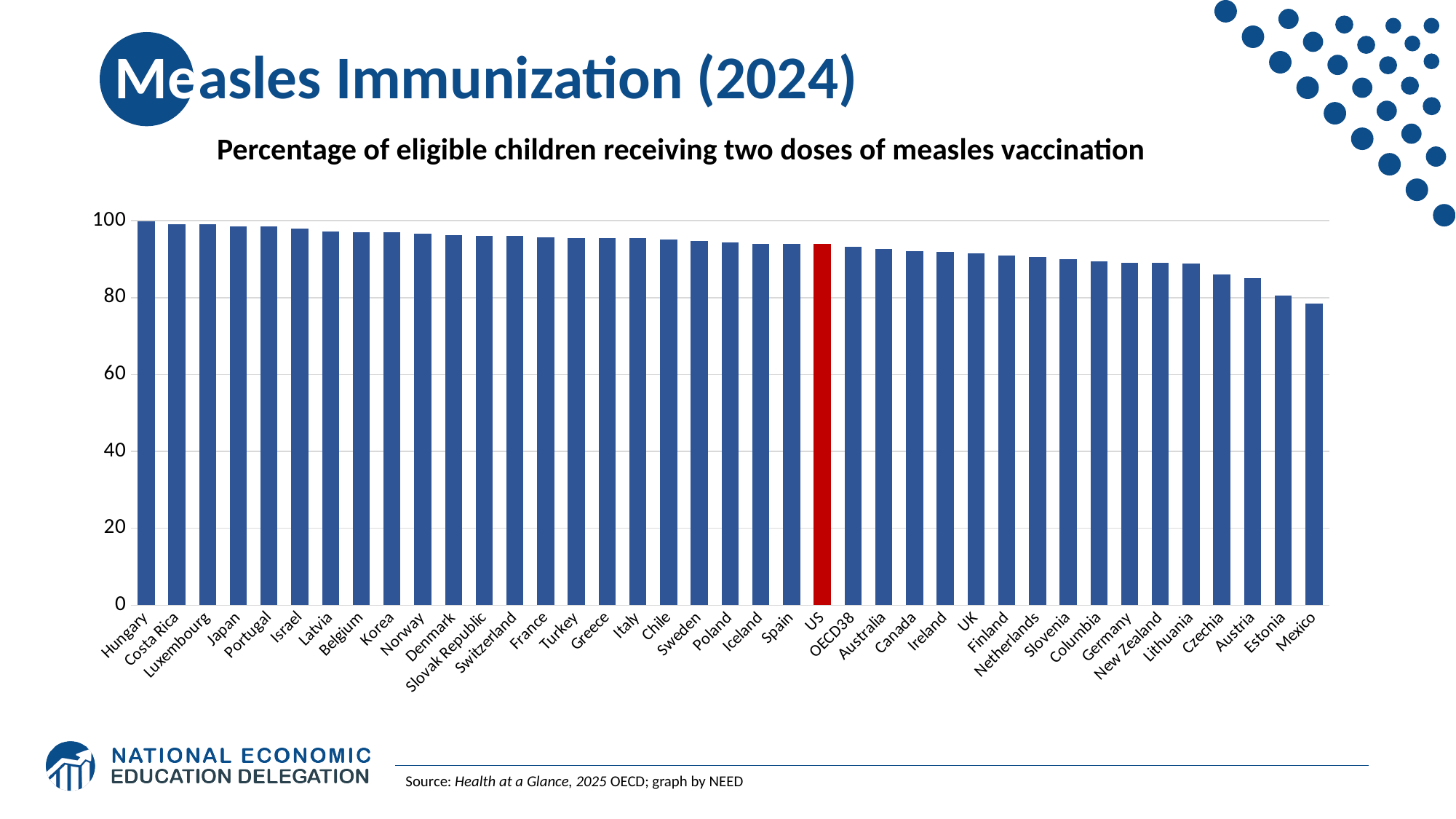
What kind of chart is shown on the slide? Bar chart Which category has the highest bar on the chart? Hungary Which category has the lowest bar on the chart? Mexico Is the value for Mexico greater or less than 80? less Which category's bar is highlighted in red? US Is the value for Austria greater or less than 80? greater Which has a larger value, Hungary or Mexico? Hungary Do the values generally rise or fall moving from left to right along the x axis? Fall Is the value for US greater or less than 80? greater How many countries/categories are plotted on the chart? 39 Which has a larger value, Estonia or Japan? Japan